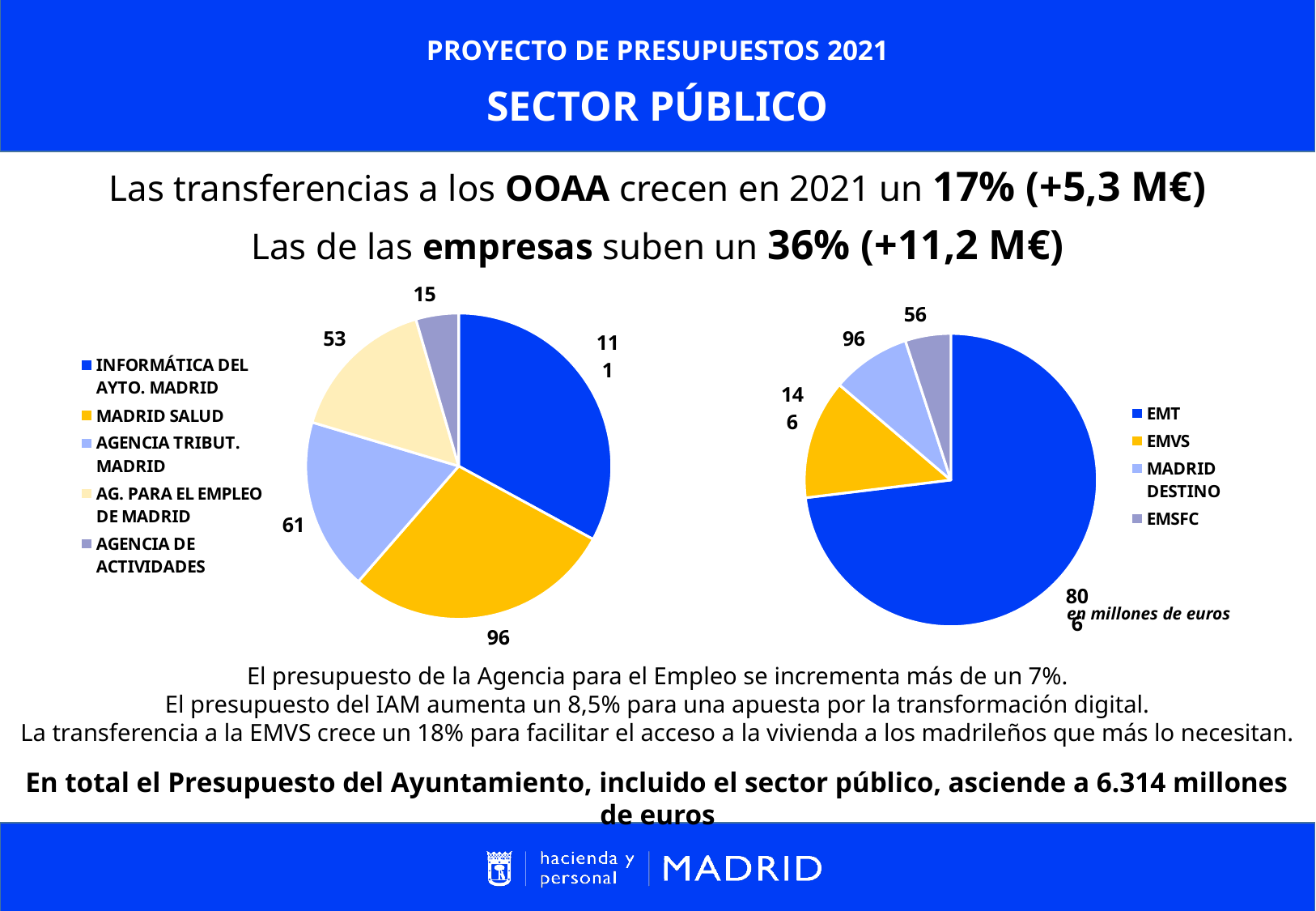
In the left pie chart, which category has the largest slice? INFORMÁTICA DEL AYTO. MADRID In the right pie chart, which is larger, MADRID DESTINO or EMSFC? MADRID DESTINO In the left pie chart, what is the value for AGENCIA DE ACTIVIDADES? 15 In the left pie chart, which category has the smallest slice? AGENCIA DE ACTIVIDADES How many categories does the left pie chart show? 5 In the right pie chart, what is the value for MADRID DESTINO? 96 How many categories does the right pie chart (empresas) show? 4 In the right pie chart, which category has the largest slice? EMT In the left pie chart, what is the value for AG. PARA EL EMPLEO DE MADRID? 53 What kind of chart is the left chart (transfers to OOAA)? pie chart In the left pie chart, what is the value for MADRID SALUD? 96 In the left pie chart, what is the difference between MADRID SALUD and AGENCIA TRIBUT. MADRID? 35